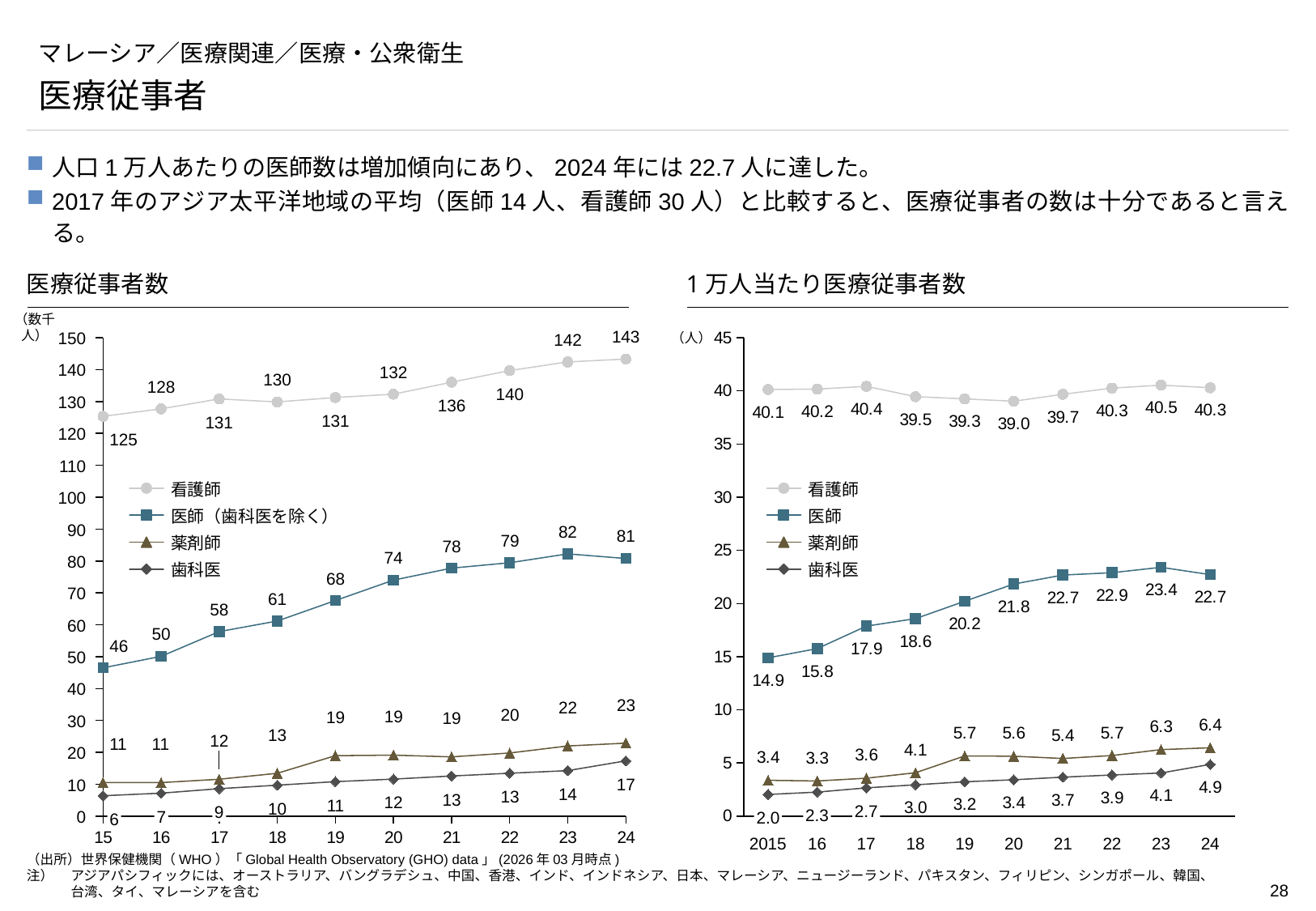
「医療従事者数」のグラフで、歯科医の値が最も低いのは何年ですか？ 15 「医療従事者数」のグラフで、2024年（24）の医師（歯科医を除く）と薬剤師の値の差はいくつですか？ 58 「1万人当たり医療従事者数」のグラフで、医師の値は2015年から2023年にかけて上昇していますか、下降していますか？ 上昇 「医療従事者数」のグラフで、2019年（19）の医師（歯科医を除く）の値はいくつですか？ 68 「1万人当たり医療従事者数」のグラフはどの種類のグラフですか？ 折れ線グラフ 「医療従事者数」のグラフで、2024年（24）の看護師の値はいくつですか？ 143 「医療従事者数」のグラフで、医師（歯科医を除く）の値が最も高いのは何年ですか？ 23 「1万人当たり医療従事者数」のグラフで、2023年（23）の薬剤師と歯科医では、どちらの値が大きいですか？ 薬剤師 「1万人当たり医療従事者数」のグラフで、看護師の値が最も低いのは何年ですか？ 20 「医療従事者数」のグラフの凡例には、いくつの系列がありますか？ 4 「1万人当たり医療従事者数」のグラフで、2024年（24）の医師の値はいくつですか？ 22.7 「1万人当たり医療従事者数」のグラフで、2015年の歯科医の値はいくつですか？ 2.0